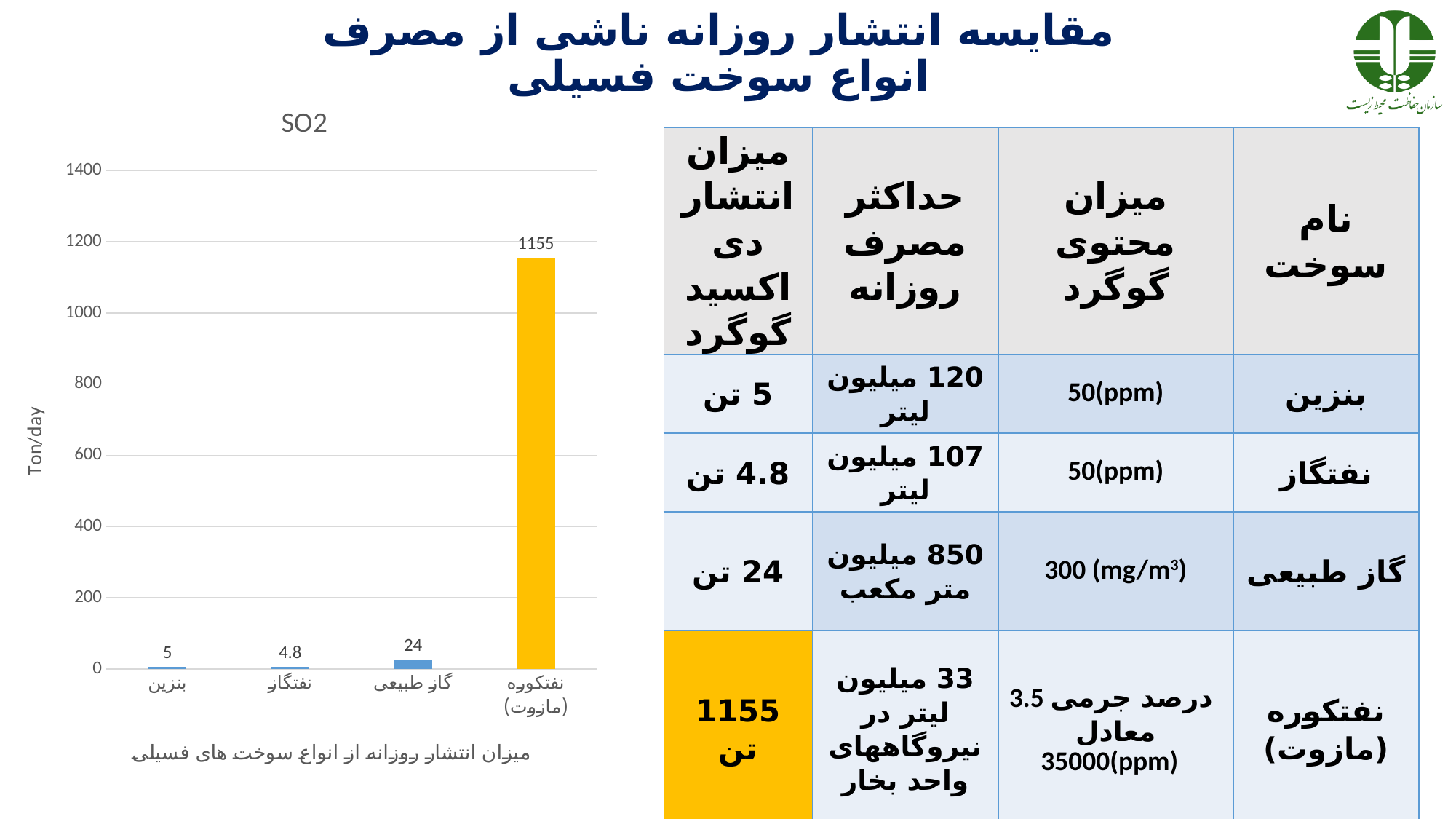
What is the SO2 emission value shown for بنزین in the chart? 5 Which fuel has the highest SO2 emission in the chart? نفتکوره (مازوت) What is the SO2 emission value shown for نفتکوره (مازوت) in the chart? 1155 What is the SO2 emission value shown for نفتگاز in the chart? 4.8 Which has a larger SO2 value, گاز طبیعی or بنزین? گاز طبیعی What unit is shown on the vertical axis of the SO2 chart? Ton/day What is the SO2 emission value shown for گاز طبیعی in the chart? 24 Which fuel has the lowest SO2 emission in the chart? نفتگاز Is the value for نفتکوره (مازوت) greater or less than 1000? greater How many fuel categories are shown in the SO2 chart? 4 What is the difference between the SO2 values for نفتکوره (مازوت) and گاز طبیعی? 1131 What type of chart is used to show the SO2 emissions? bar chart